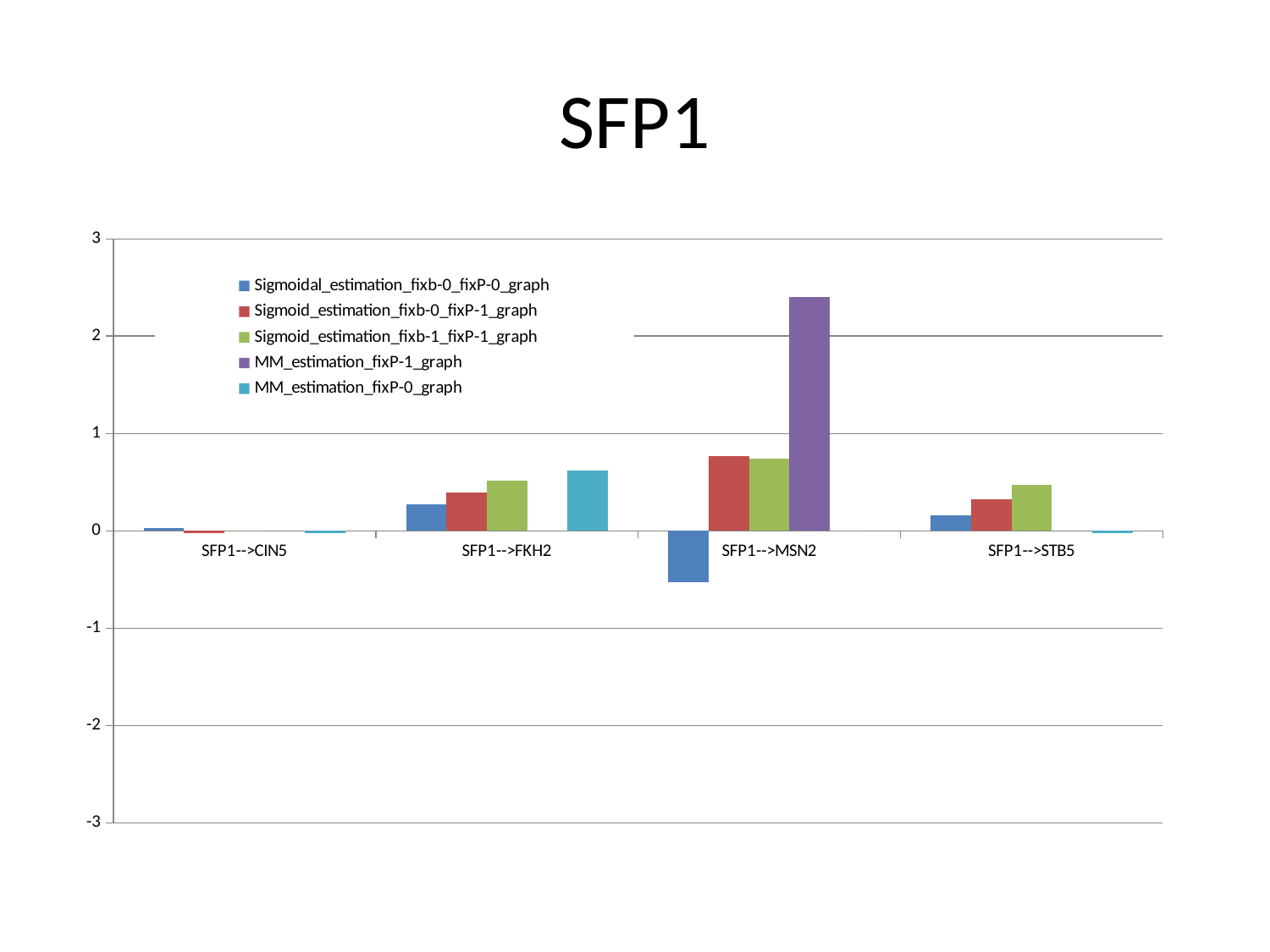
For SFP1-->STB5, which is larger: Sigmoid_estimation_fixb-1_fixP-1_graph or Sigmoidal_estimation_fixb-0_fixP-0_graph? Sigmoid_estimation_fixb-1_fixP-1_graph What is the title of the chart? SFP1 For SFP1-->FKH2, which is larger: MM_estimation_fixP-0_graph or Sigmoidal_estimation_fixb-0_fixP-0_graph? MM_estimation_fixP-0_graph What colour represents the MM_estimation_fixP-1_graph series? purple Is the value of MM_estimation_fixP-1_graph for SFP1-->MSN2 greater or less than 2? greater Is the value of MM_estimation_fixP-0_graph for SFP1-->FKH2 greater or less than 1? less Which series has the lowest value for SFP1-->MSN2? Sigmoidal_estimation_fixb-0_fixP-0_graph Is the value of Sigmoidal_estimation_fixb-0_fixP-0_graph for SFP1-->MSN2 greater or less than 0? less How many categories are shown on the x axis? 4 Which category contains the tallest bar in the chart? SFP1-->MSN2 What kind of chart is shown on the slide? bar chart How many series does the legend list? 5